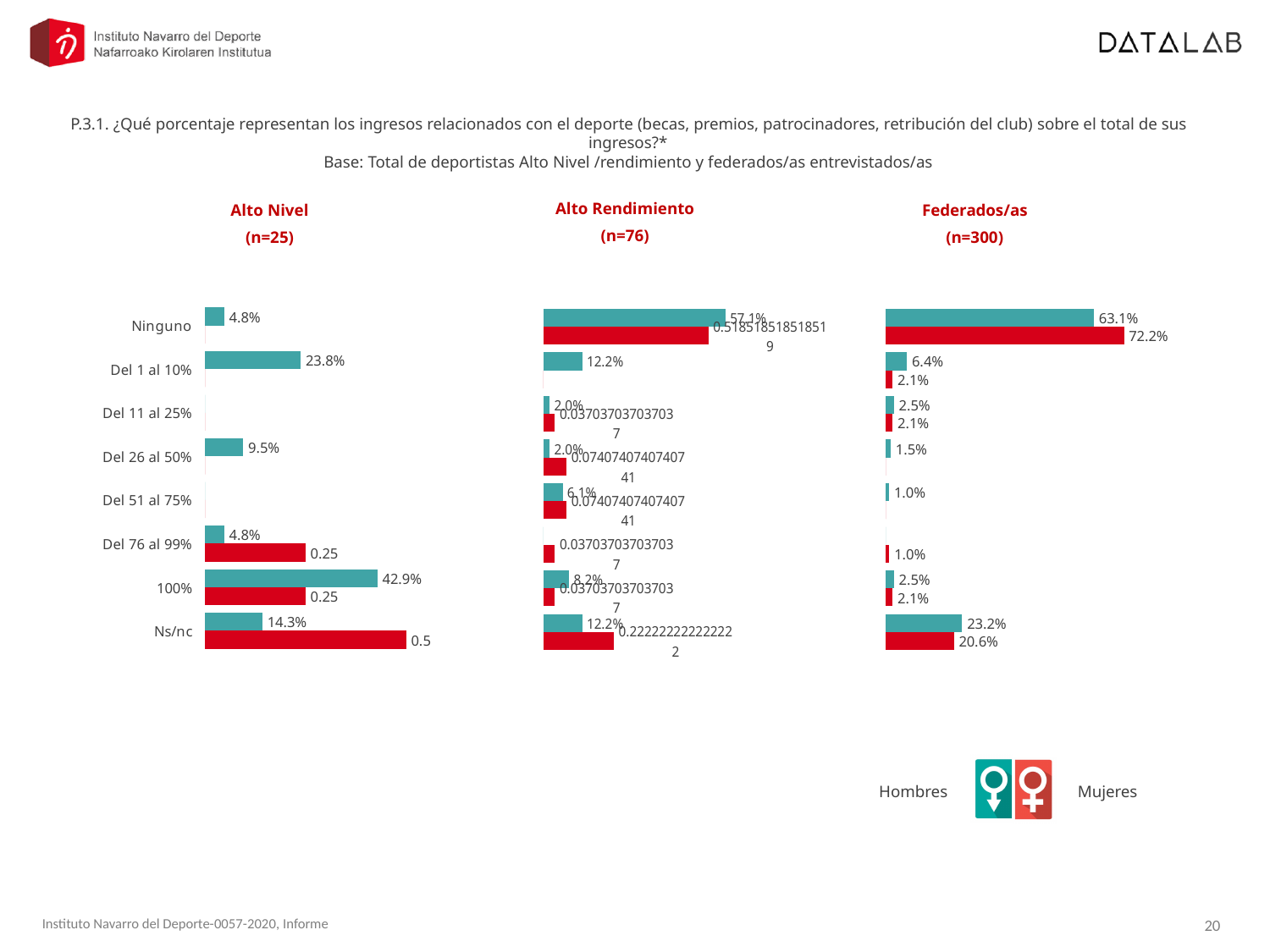
How many series are shown in each chart on the slide? 2 In the Alto Rendimiento (n=76) chart, what is the Hombres value for Ninguno? 57.1% In the Alto Nivel (n=25) chart, what is the Hombres value for 100%? 42.9% In the Federados/as (n=300) chart, what is the Hombres value for Ns/nc? 23.2% In the Federados/as (n=300) chart, which is larger for Ns/nc: the Hombres value or the Mujeres value? Hombres In the Alto Nivel (n=25) chart, what is the difference between the Hombres values for 100% and Del 1 al 10%? 19.1% In the Federados/as (n=300) chart, what is the Mujeres value for Ninguno? 72.2% How many categories are listed on the vertical axis of the Alto Nivel (n=25) chart? 8 In the Federados/as (n=300) chart, which category has the highest Mujeres value? Ninguno In the Federados/as (n=300) chart, what is the difference between the Mujeres and Hombres values for Ninguno? 9.1% What type of chart is the Federados/as (n=300) chart? Bar chart In the Alto Nivel (n=25) chart, which category has the highest Hombres value? 100%